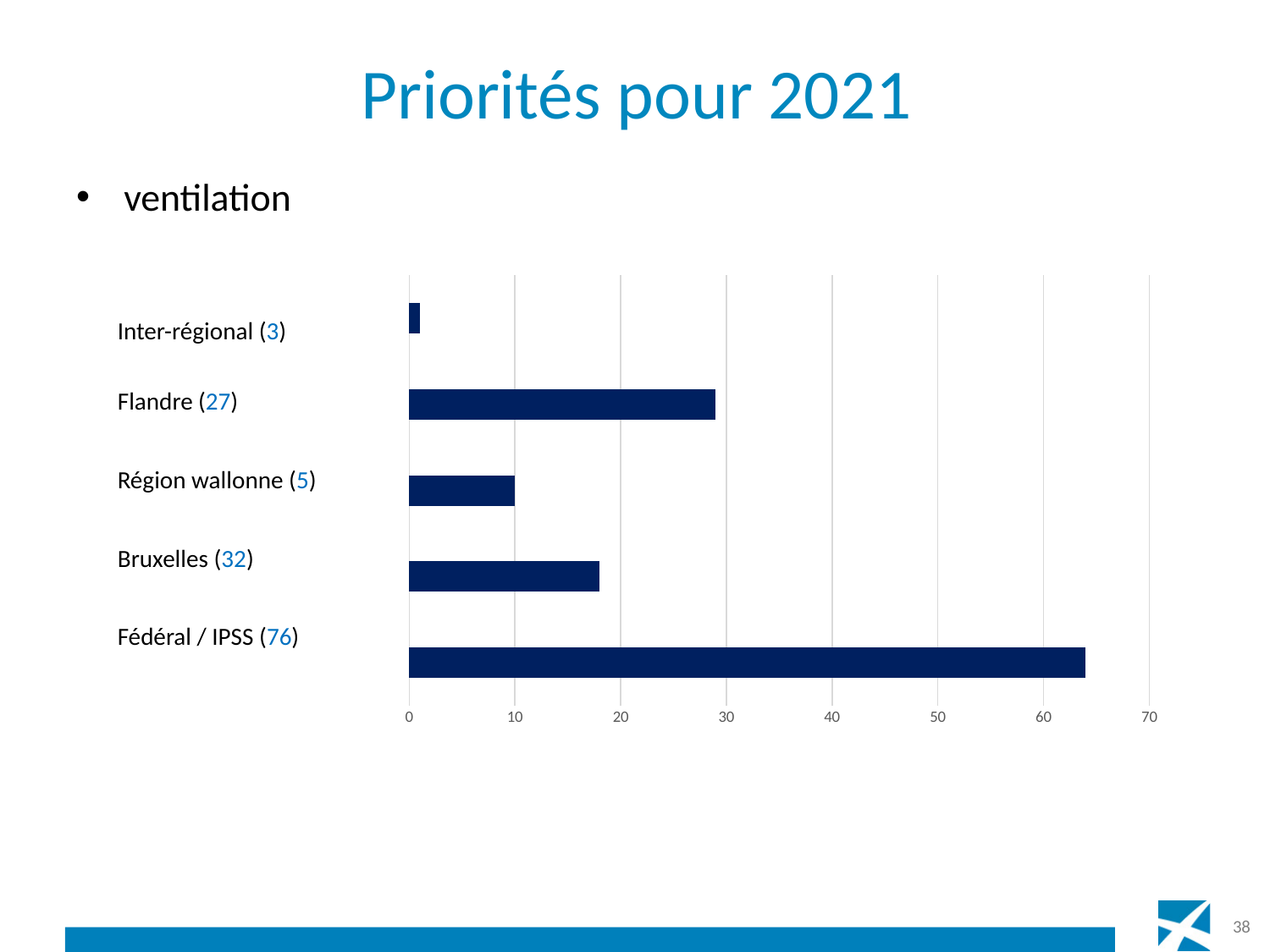
What is the highest value shown on the horizontal axis of the chart? 70 Is the value for Fédéral / IPSS greater or less than 60? greater Which category has the shortest bar in the chart? Inter-régional Which category has the longest bar in the chart? Fédéral / IPSS Is the value for Flandre greater or less than 20? greater Which has the longer bar, Flandre or Bruxelles? Flandre Is the value for Bruxelles greater or less than 20? less What is the title of the slide containing the chart? Priorités pour 2021 Which has the longer bar, Bruxelles or Région wallonne? Bruxelles How many categories are plotted in the chart? 5 What kind of chart is shown on the slide? bar chart